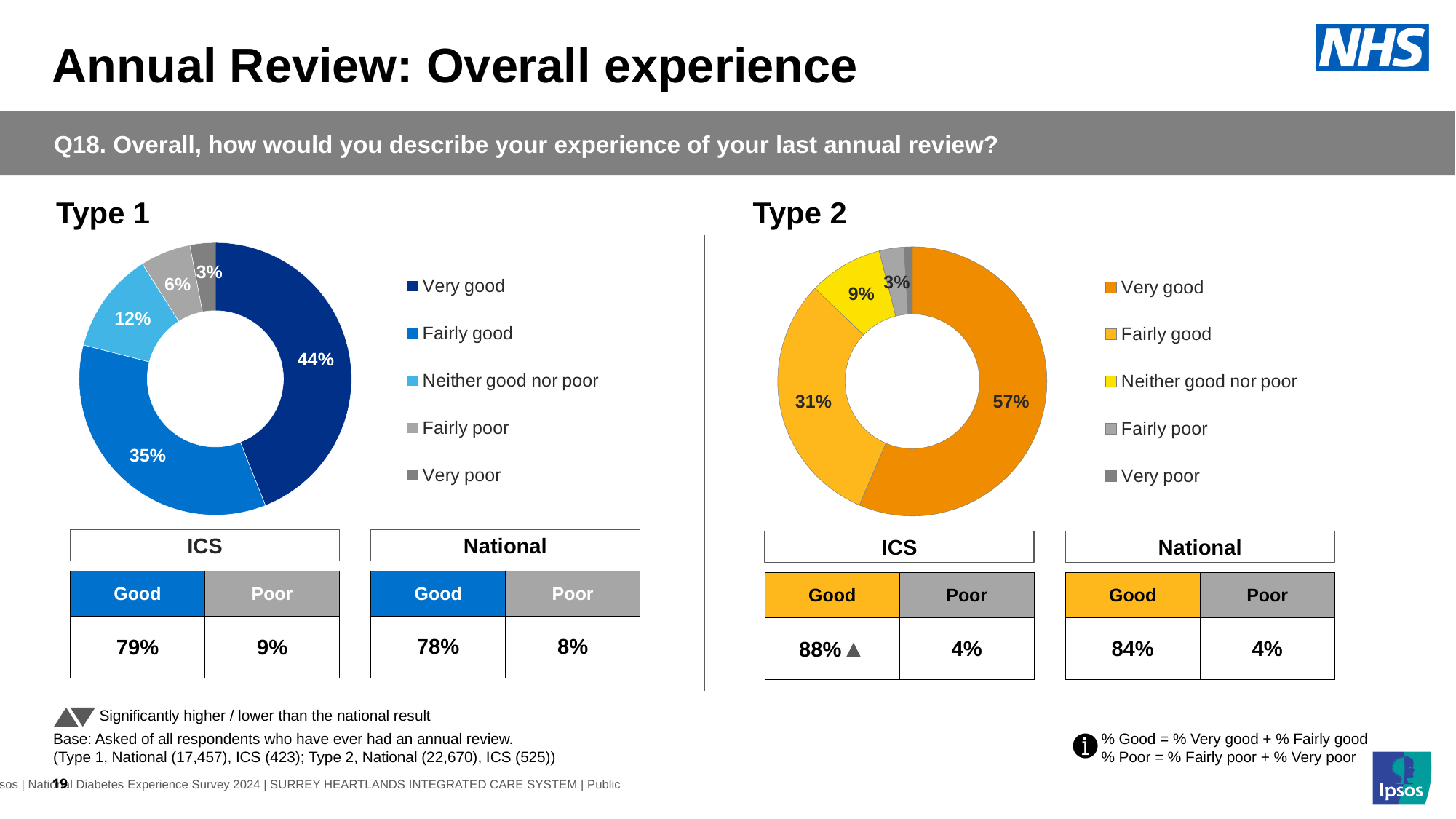
What kind of chart is used for Type 2? Donut (pie) chart In the Type 2 chart, what is the difference between the Very good and Fairly good shares? 26 percentage points In the Type 2 chart, what percentage of respondents said Neither good nor poor? 9% In the Type 1 chart, what percentage of respondents said Fairly good? 35% In the Type 2 chart, what percentage of respondents said their experience was Very good? 57% Which is larger: the Very good share in the Type 1 chart or the Very good share in the Type 2 chart? Type 2 How many categories does the legend of the Type 1 chart list? 5 In the Type 1 chart, which category has the largest share? Very good In the Type 1 chart, which category has the smallest share? Very poor In the Type 2 chart, which category has the largest share? Very good In the Type 1 chart, what is the difference between the Very good and Fairly good shares? 9 percentage points In the Type 1 chart, what percentage of respondents said their experience was Very good? 44%